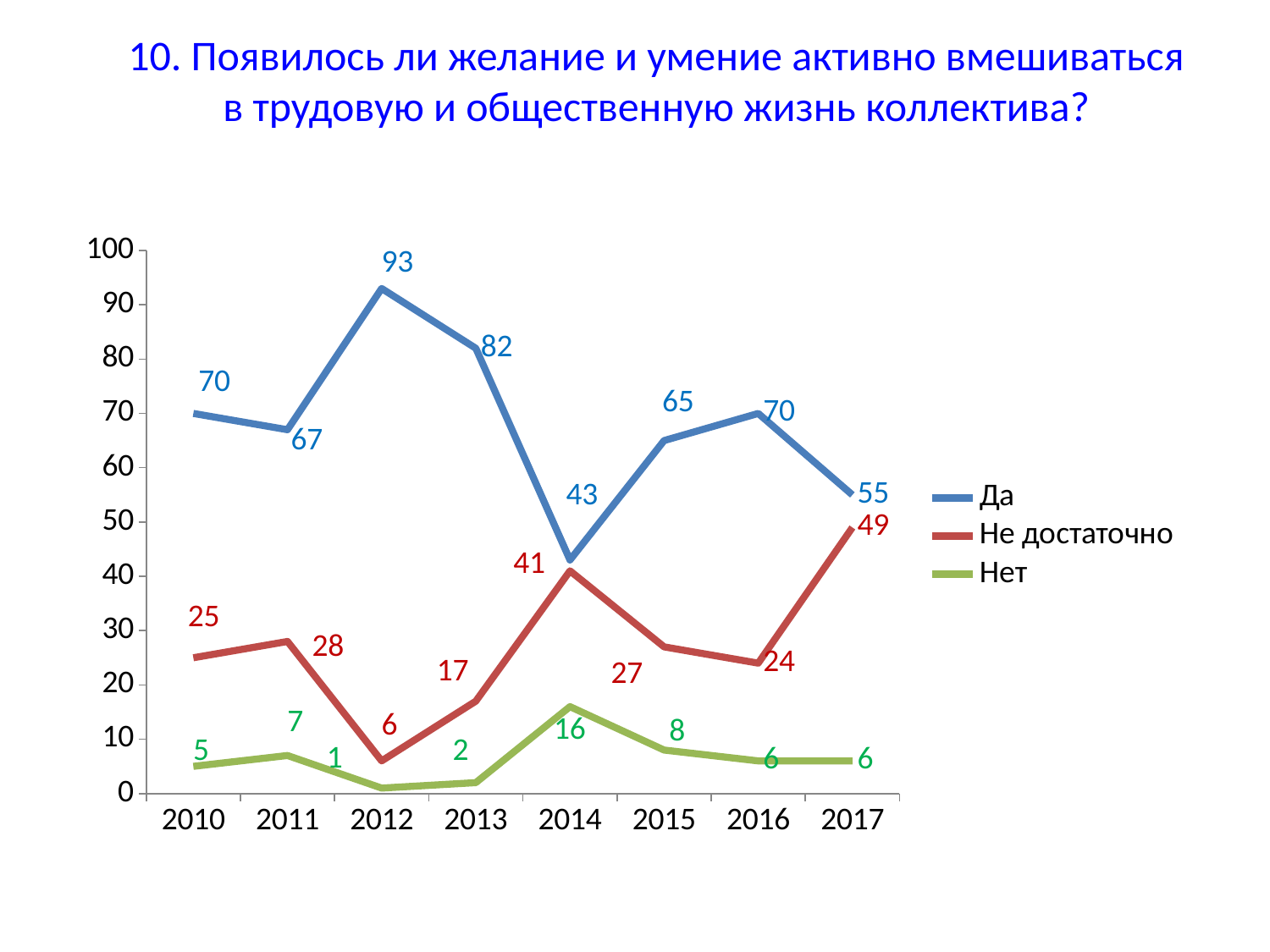
In which year is the value for "Да" the highest? 2012 What is the difference between the "Да" values in 2012 and 2014? 50 In which year is the value for "Да" the lowest? 2014 Does the value for "Да" rise or fall from 2016 to 2017? fall How many years are shown on the x axis? 8 What is the value for "Не достаточно" in 2017? 49 What is the value for "Нет" in 2014? 16 In which year is the value for "Нет" the lowest? 2012 What type of chart is shown on the slide? line chart Which is larger in 2014: the value for "Да" or the value for "Не достаточно"? Да How many series does the legend list? 3 What is the value for "Да" in 2012? 93